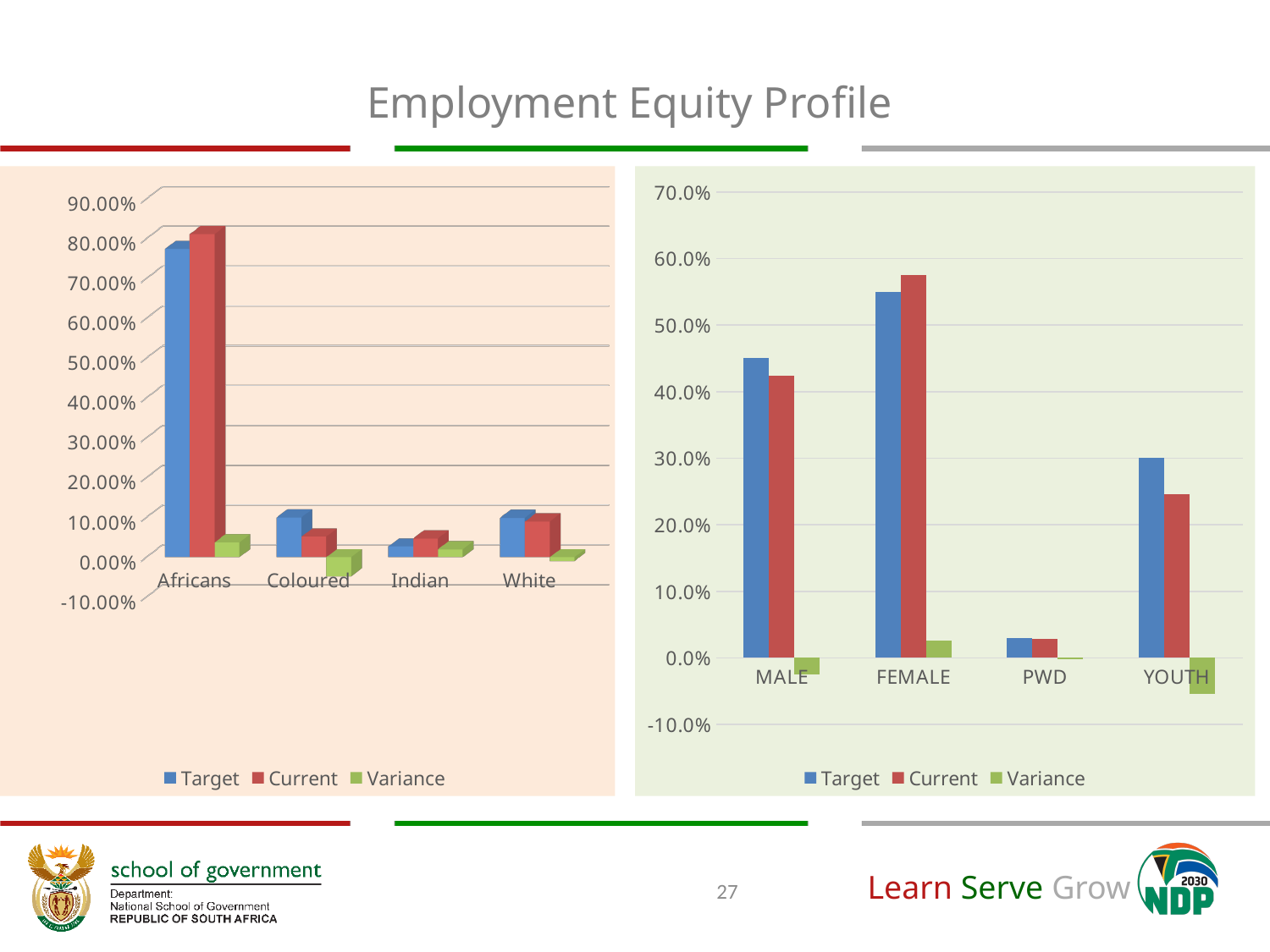
On the left chart, which category has the highest Target value? Africans On the right chart, is the Current value for YOUTH greater or less than 30.0%? less On the right chart, is the Target value for MALE greater or less than 40.0%? greater How many categories are shown on the right chart? 4 On the left chart, is the Target value for Africans greater or less than 70.00%? greater On the right chart, which category has the highest Current value? FEMALE How many series does the legend of the left chart list? 3 On the right chart, which is larger for YOUTH, the Target or the Current value? Target On the right chart, which category has the lowest Target value? PWD What kind of chart is the right chart? bar chart On the left chart, which is larger for Africans, the Target or the Current value? Current